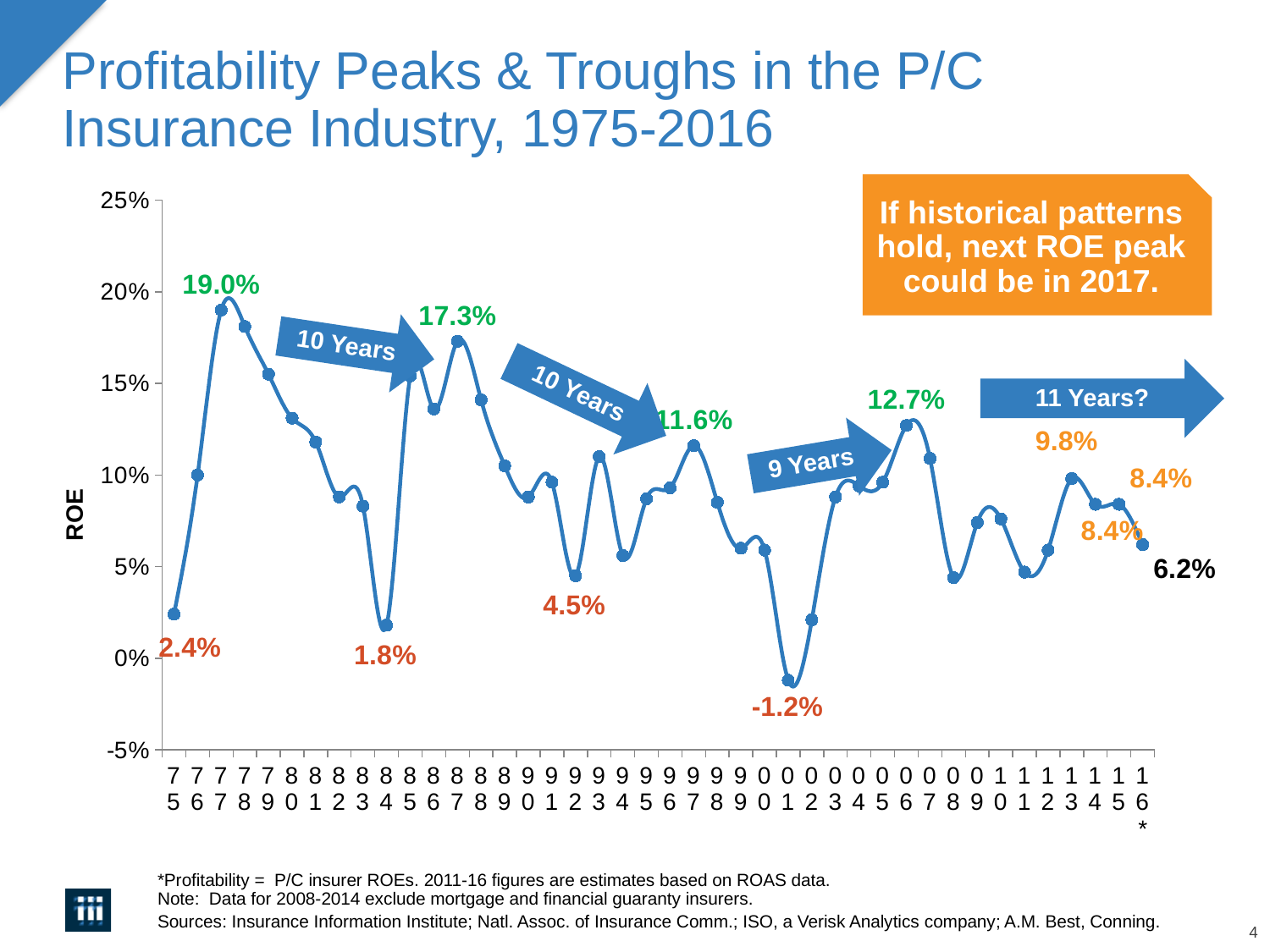
What was the P/C insurance industry ROE in 1977? 19.0% What was the ROE in 1984? 1.8% Which year had the higher ROE peak, 1987 or 2006? 1987 How much higher was the 1977 peak ROE (19.0%) than the 1987 peak ROE (17.3%)? 1.7 percentage points In which year did ROE reach its lowest labeled trough? 2001 Is the ROE value for 1980 greater or less than 10%? greater Does ROE rise or fall from 2013 to 2016? fall In which year did ROE reach its highest labeled peak? 1977 What is the label on the vertical axis of the chart? ROE What is the ROE value labeled for 2016? 6.2% What was the ROE in 2001? -1.2% What kind of chart is shown on the slide? line chart